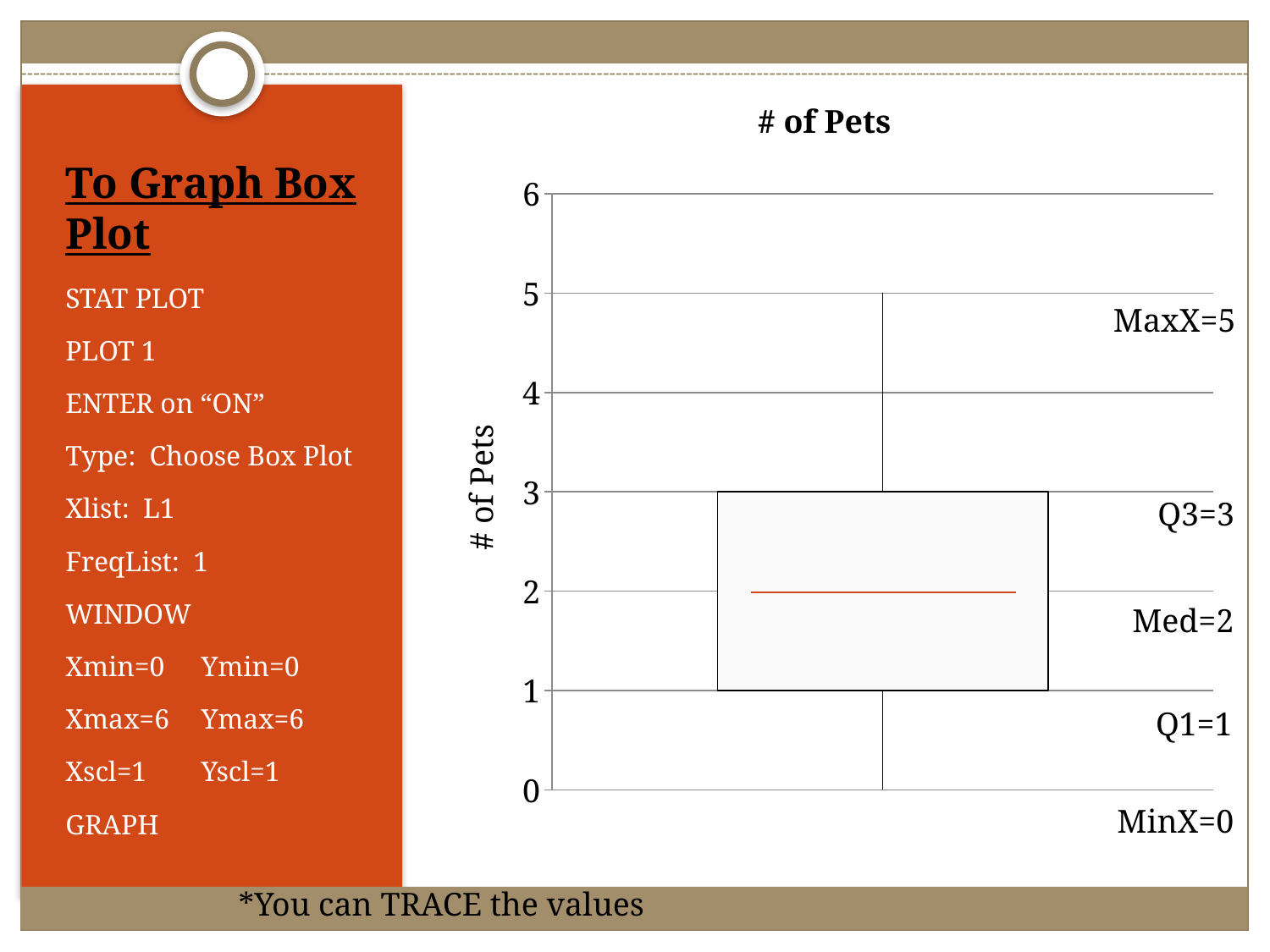
Which is larger on the box plot, Q3 or the median? Q3 What is the median (Med) shown on the box plot? 2 What kind of chart is shown on the slide? box plot What is the difference between MaxX and MinX on the box plot? 5 What is the title of the chart? # of Pets What is the first quartile (Q1) shown on the box plot? 1 What is the highest tick value shown on the vertical axis? 6 What is the label on the vertical axis of the chart? # of Pets What is the minimum value (MinX) shown on the box plot? 0 What is the difference between Q3 and Q1 on the box plot? 2 What is the maximum value (MaxX) shown on the box plot? 5 What is the third quartile (Q3) shown on the box plot? 3